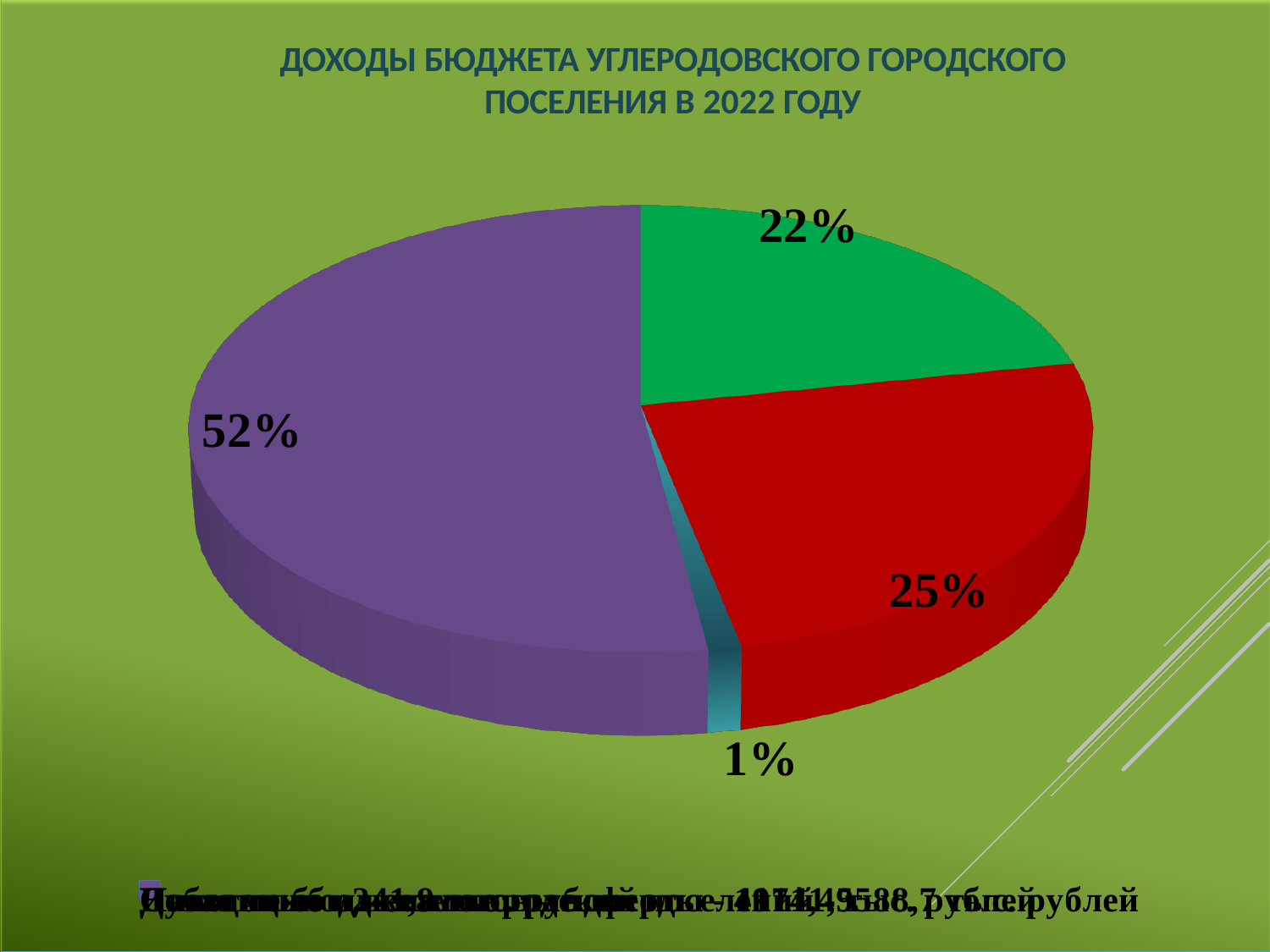
What is the title of the chart? ДОХОДЫ БЮДЖЕТА УГЛЕРОДОВСКОГО ГОРОДСКОГО ПОСЕЛЕНИЯ В 2022 ГОДУ What kind of chart is shown on the slide? pie chart How many slices does the pie chart have? 4 Which is larger, the red slice or the green slice? the red slice What share of the pie does the purple slice represent? 52% What is the difference in percentage points between the purple slice and the red slice? 27 Which slice of the pie chart is the smallest? the teal slice (1%) What share of the pie does the red slice represent? 25% Which slice of the pie chart is the largest? the purple slice (52%) What share of the pie does the small teal slice represent? 1% Is the share of the purple slice greater or less than 50%? greater